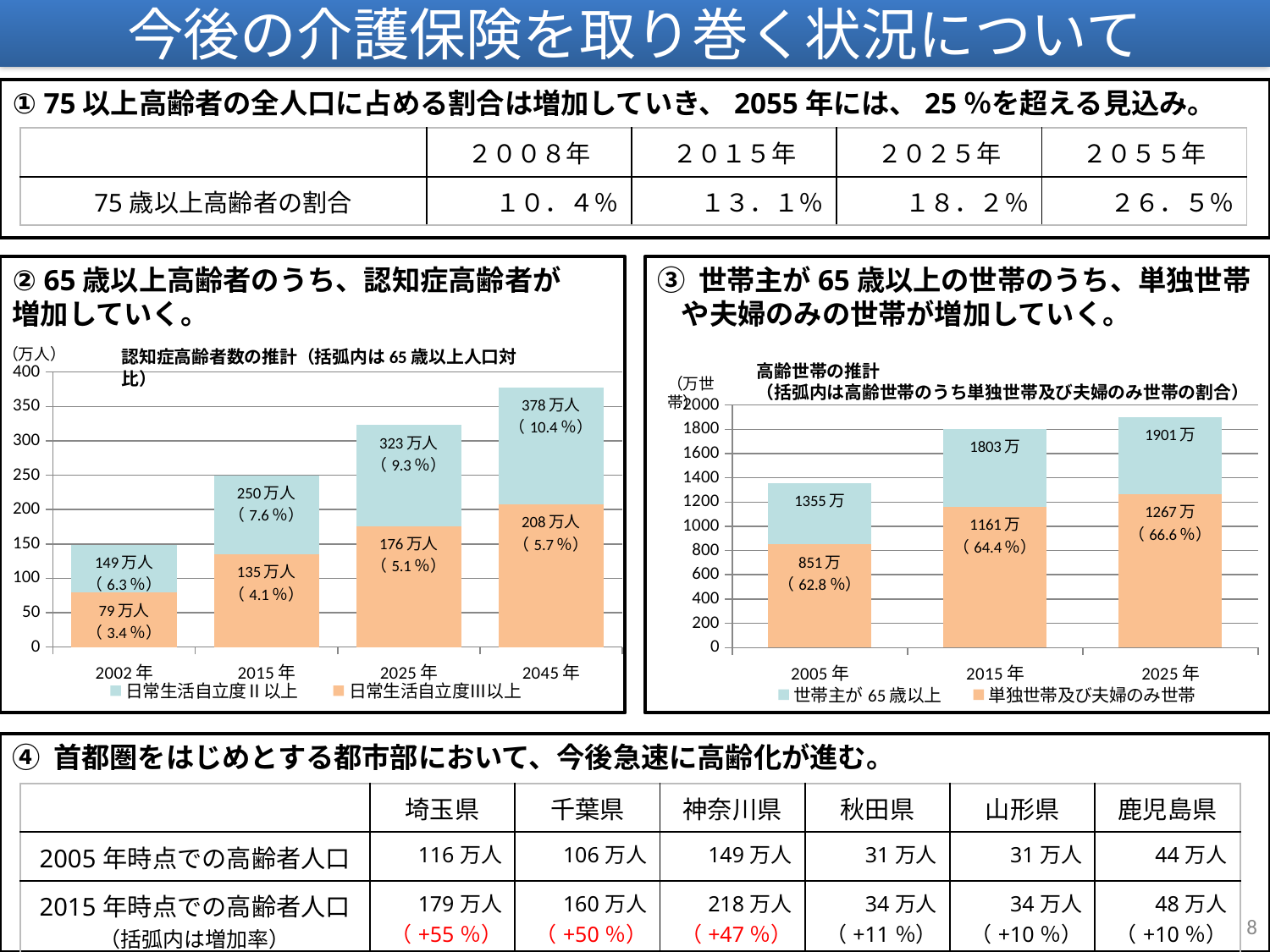
In the chart titled 認知症高齢者数の推計, what is the difference between the 日常生活自立度Ⅱ以上 values printed for 2045年 (378万人) and 2025年 (323万人)? 55万人 In the chart titled 認知症高齢者数の推計, what is the label shown on the 日常生活自立度Ⅲ以上 segment for 2002年? 79万人（3.4%） In the chart titled 認知症高齢者数の推計, what is the label shown on the 日常生活自立度Ⅱ以上 segment for 2045年? 378万人（10.4%） In the chart titled 高齢世帯の推計, what value is printed on the 世帯主が65歳以上 segment for 2015年? 1803万 In the chart titled 高齢世帯の推計, how many series does the legend list? 2 In the chart titled 認知症高齢者数の推計, how many year categories are shown on the x axis? 4 In the chart titled 認知症高齢者数の推計, do the bar heights rise or fall from 2002年 to 2045年? rise In the chart titled 高齢世帯の推計, what is the label shown on the 単独世帯及び夫婦のみ世帯 segment for 2025年? 1267万（66.6%） What type of chart is the chart titled 高齢世帯の推計? bar chart In the chart titled 高齢世帯の推計, which year has the lowest bar? 2005年 In the chart titled 認知症高齢者数の推計, what value is printed on the 日常生活自立度Ⅲ以上 segment for 2025年? 176万人 In the chart titled 高齢世帯の推計, what is the difference between the 単独世帯及び夫婦のみ世帯 values for 2025年 (1267万) and 2015年 (1161万)? 106万